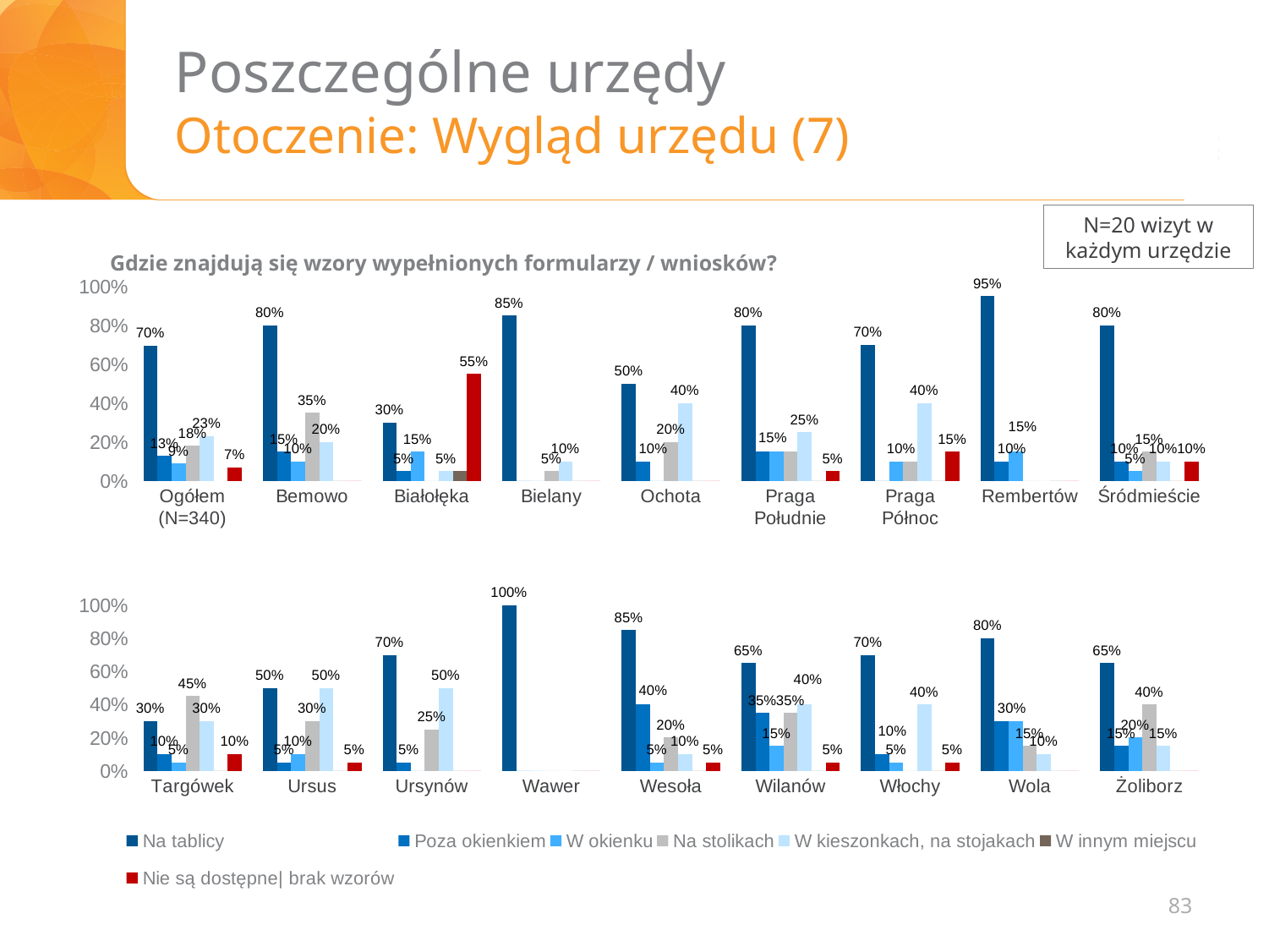
In the top chart, which category has the lowest 'Na tablicy' value? Białołęka In the top chart, which district has the highest 'Na tablicy' value? Rembertów What type of chart is used on this slide? Bar chart In the bottom chart, what is the value for 'Na tablicy' in Wawer? 100% In the bottom chart, which is larger: the 'Na tablicy' value for Ursynów or for Ursus? Ursynów How many districts (categories) are shown in the bottom chart? 9 How many series does the legend list? 7 In the top chart, what is the value of the 'Nie są dostępne| brak wzorów' bar for Białołęka? 55% In the bottom chart, what is the value for 'Na stolikach' in Targówek? 45% In the top chart, what is the value for 'Na tablicy' in Rembertów? 95% In the bottom chart, which district has the lowest 'Na tablicy' value? Targówek In the top chart, what is the difference between the 'Na tablicy' values for Bielany and Ochota? 35%